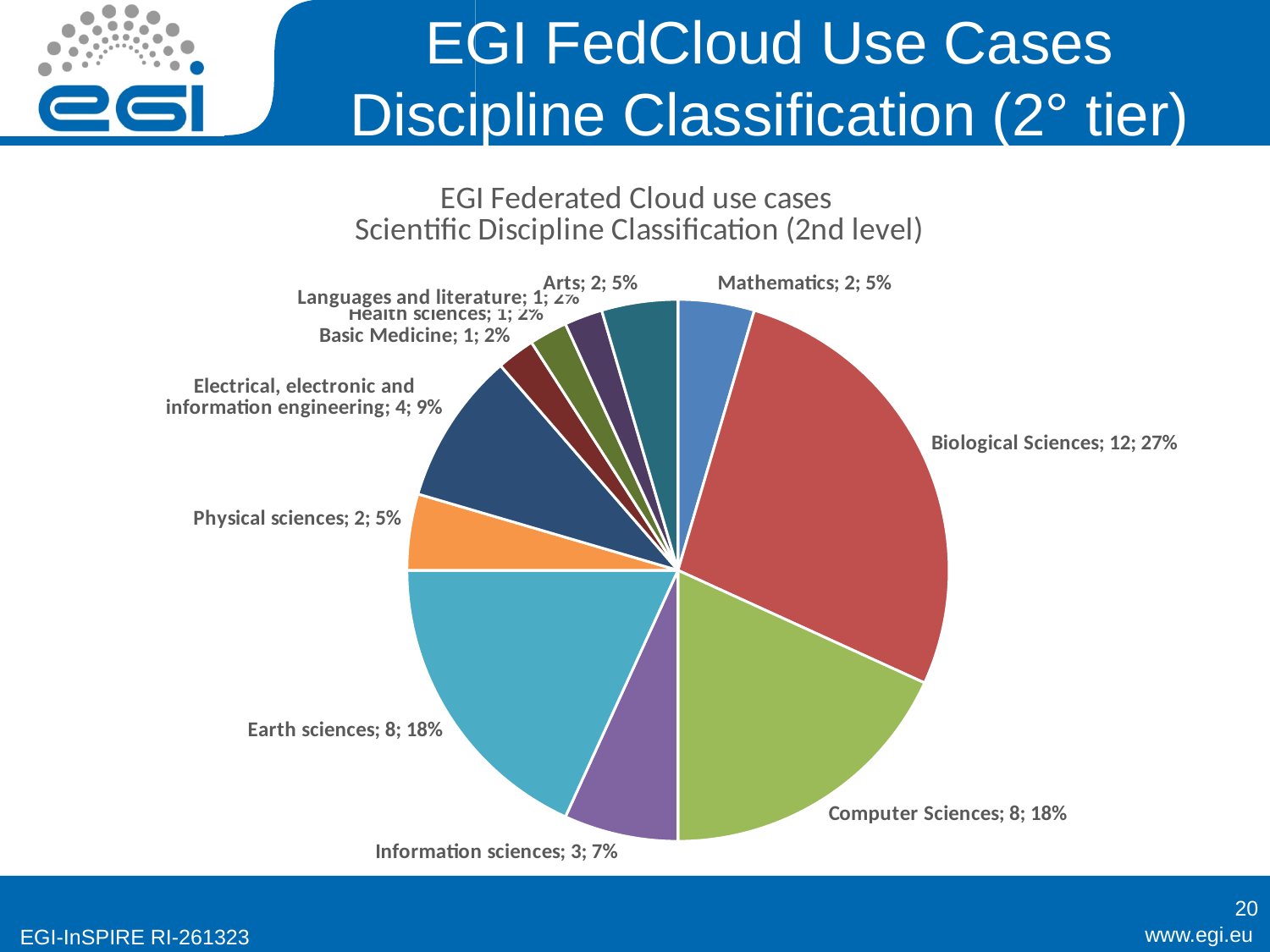
Which has more use cases, Information sciences or Physical sciences? Information sciences What is the difference in use cases between Biological Sciences and Computer Sciences? 4 What is the title of the chart? EGI Federated Cloud use cases Scientific Discipline Classification (2nd level) What percentage share does Earth sciences have? 18% How many discipline categories are shown in the pie chart? 11 Which discipline has the largest slice of the pie? Biological Sciences What percentage share does Mathematics have? 5% How many use cases are in the Biological Sciences slice? 12 How many use cases does Electrical, electronic and information engineering account for? 4 How many use cases does Basic Medicine have? 1 What kind of chart is shown on the slide? pie chart What is the difference in use cases between Earth sciences and Information sciences? 5